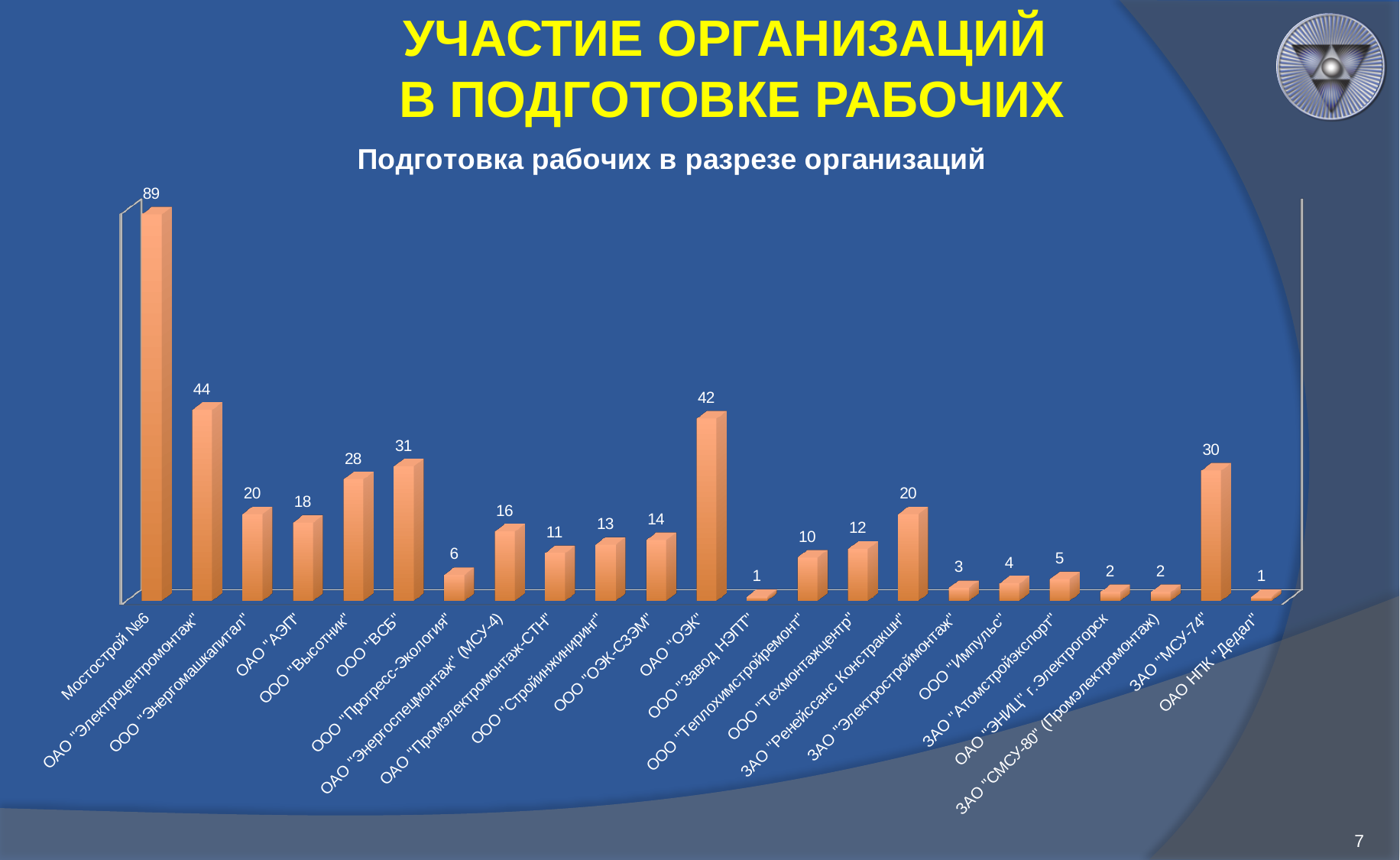
What is the value for Мостострой №6? 89 What is the value for ОАО "ОЭК"? 42 Which is larger, the value for ОАО "ОЭК" or the value for ОАО "Электроцентромонтаж"? ОАО "Электроцентромонтаж" How many organisations are shown in the chart? 23 What is the title of the chart? Подготовка рабочих в разрезе организаций What is the value for ЗАО "МСУ-74"? 30 Which is larger, the value for ООО "Теплохимстройремонт" or the value for ООО "Техмонтажцентр"? ООО "Техмонтажцентр" What is the difference between the values for ООО "ВСБ" and ООО "Высотник"? 3 What is the difference between the values for Мостострой №6 and ОАО "Электроцентромонтаж"? 45 What kind of chart is shown on the slide? Bar chart What is the value for ООО "Прогресс-Экология"? 6 Which organisation has the highest value? Мостострой №6